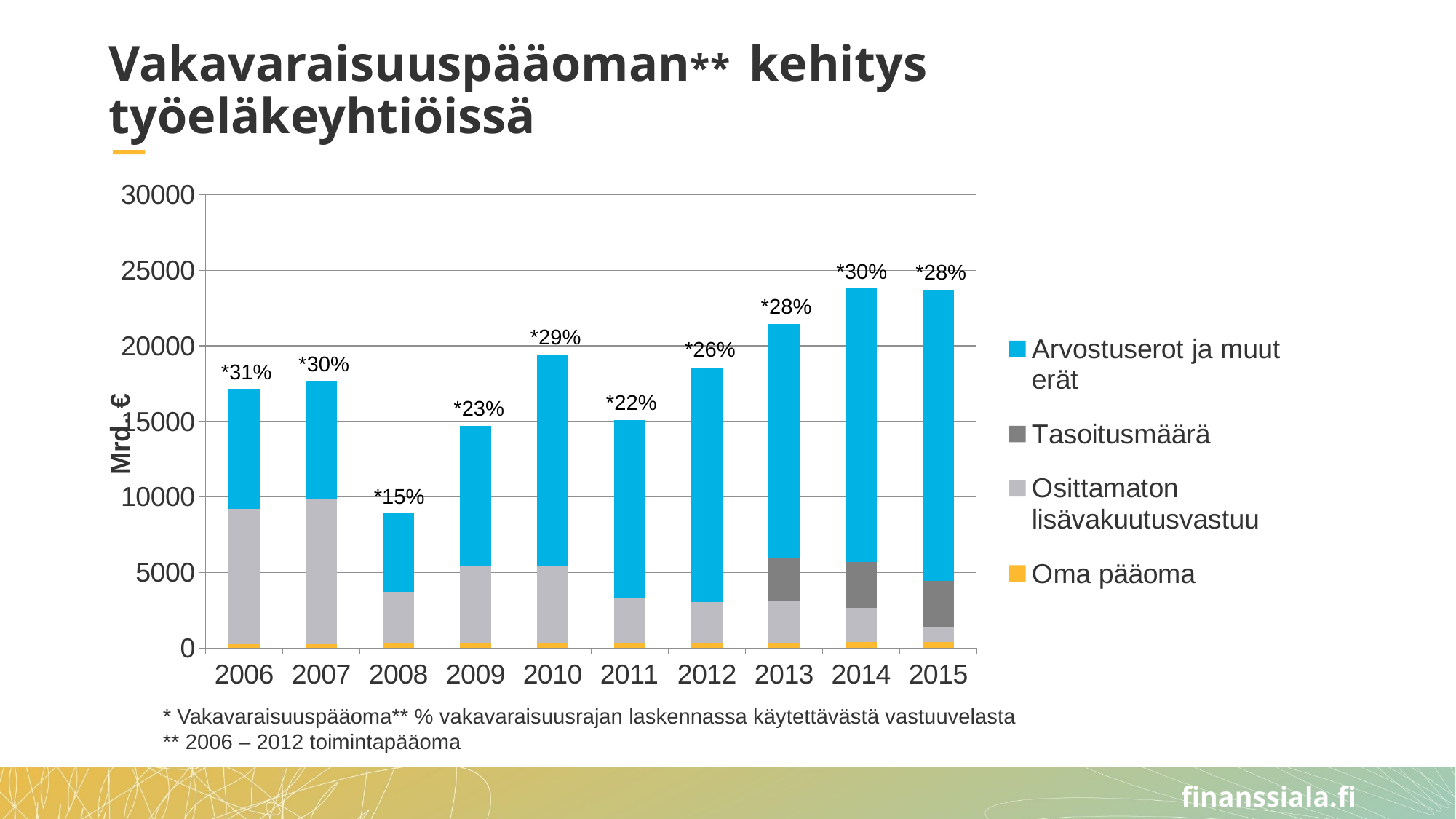
Is the total stacked bar for 2008 greater or less than 10000? less What percentage label is shown above the bar for 2008? *15% Which year has the lowest total stacked bar? 2008 How many years are shown on the x axis of the chart? 10 Which is larger, the total stacked bar for 2010 or for 2011? 2010 Is the total stacked bar for 2014 greater or less than 20000? greater What kind of chart is shown on the slide? Stacked bar chart What percentage label is shown above the bar for 2011? *22% Which year has the highest percentage label above its bar? 2006 Which legend entry is shown in yellow? Oma pääoma How many series does the chart legend list? 4 What percentage label is shown above the bar for 2014? *30%